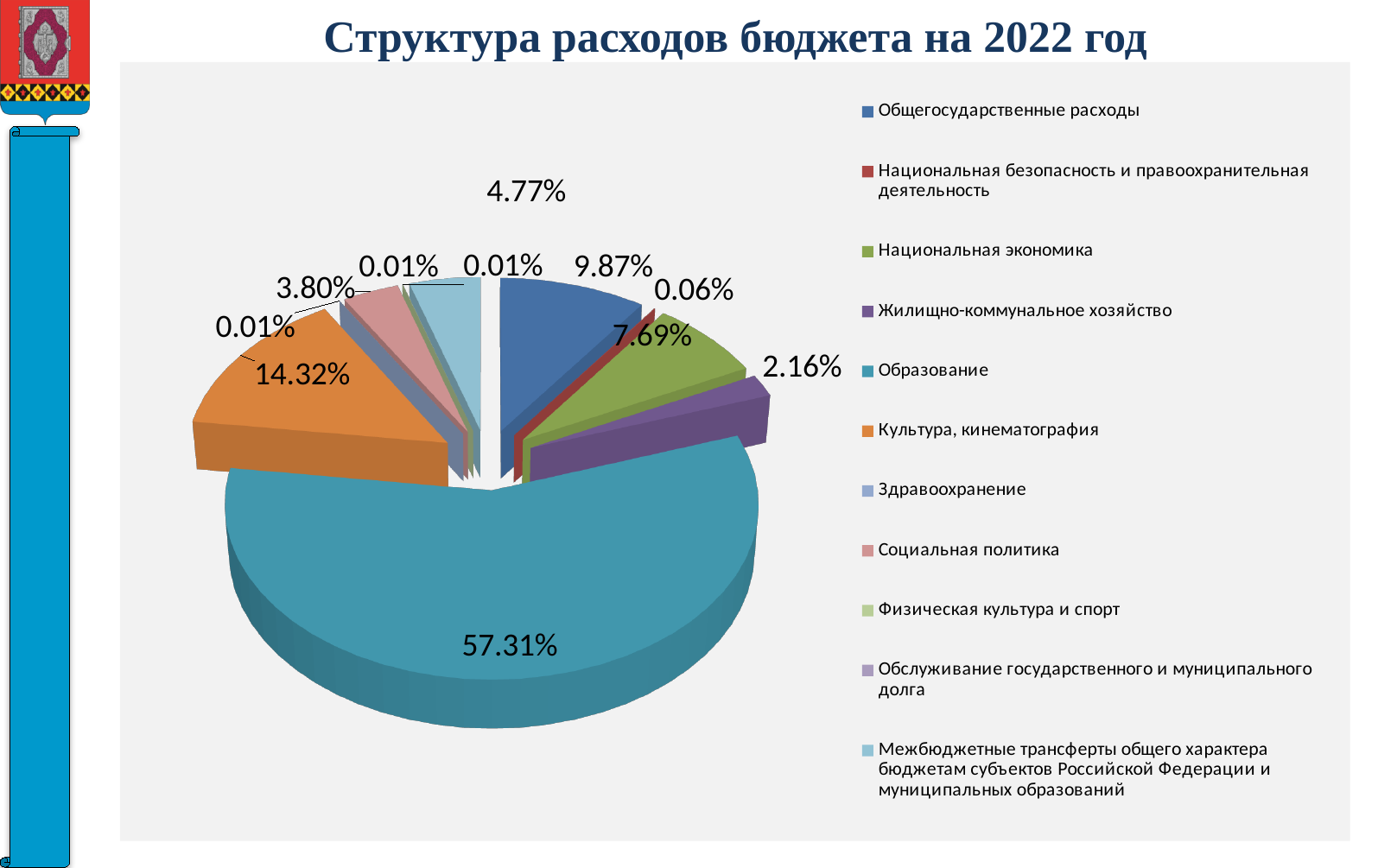
What is the difference between the shares for Образование and Культура, кинематография? 42.99% What share is shown for Социальная политика? 3.80% What share is shown for Жилищно-коммунальное хозяйство? 2.16% Which category has the largest share of the pie? Образование What share is shown for Общегосударственные расходы? 9.87% Which is larger: the share for Культура, кинематография or for Общегосударственные расходы? Культура, кинематография What share is shown for Культура, кинематография? 14.32% How many categories does the legend list? 11 What share of the budget expenditure is Образование? 57.31% What type of chart is shown on the slide? pie chart What share is shown for Национальная экономика? 7.69% What is the title of the chart? Структура расходов бюджета на 2022 год